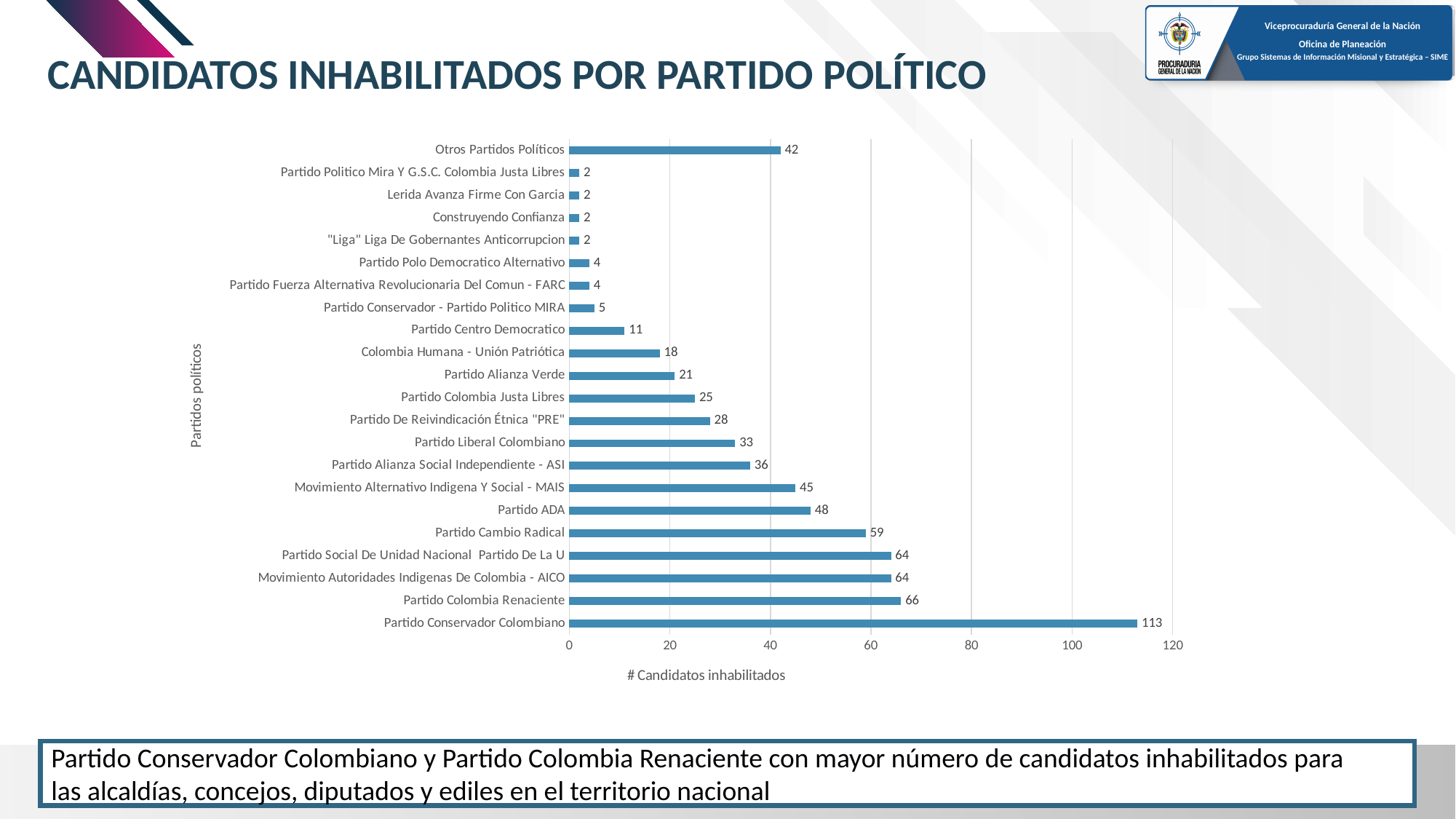
What is the label of the horizontal axis? # Candidatos inhabilitados Which is larger, the value for Partido Liberal Colombiano or the value for Partido Alianza Verde? Partido Liberal Colombiano Is the value for Partido Colombia Renaciente greater or less than 60? greater What is the value for Otros Partidos Políticos? 42 What kind of chart is shown on the slide? bar chart What is the value for Partido Cambio Radical? 59 Which party has the highest number of candidatos inhabilitados? Partido Conservador Colombiano What is the difference between Partido Conservador Colombiano and Partido Colombia Renaciente? 47 How many political parties are listed on the chart? 22 How many candidatos inhabilitados does Partido Conservador Colombiano have? 113 What is the value for Partido Centro Democratico? 11 What is the difference between Partido ADA and Movimiento Alternativo Indigena Y Social - MAIS? 3